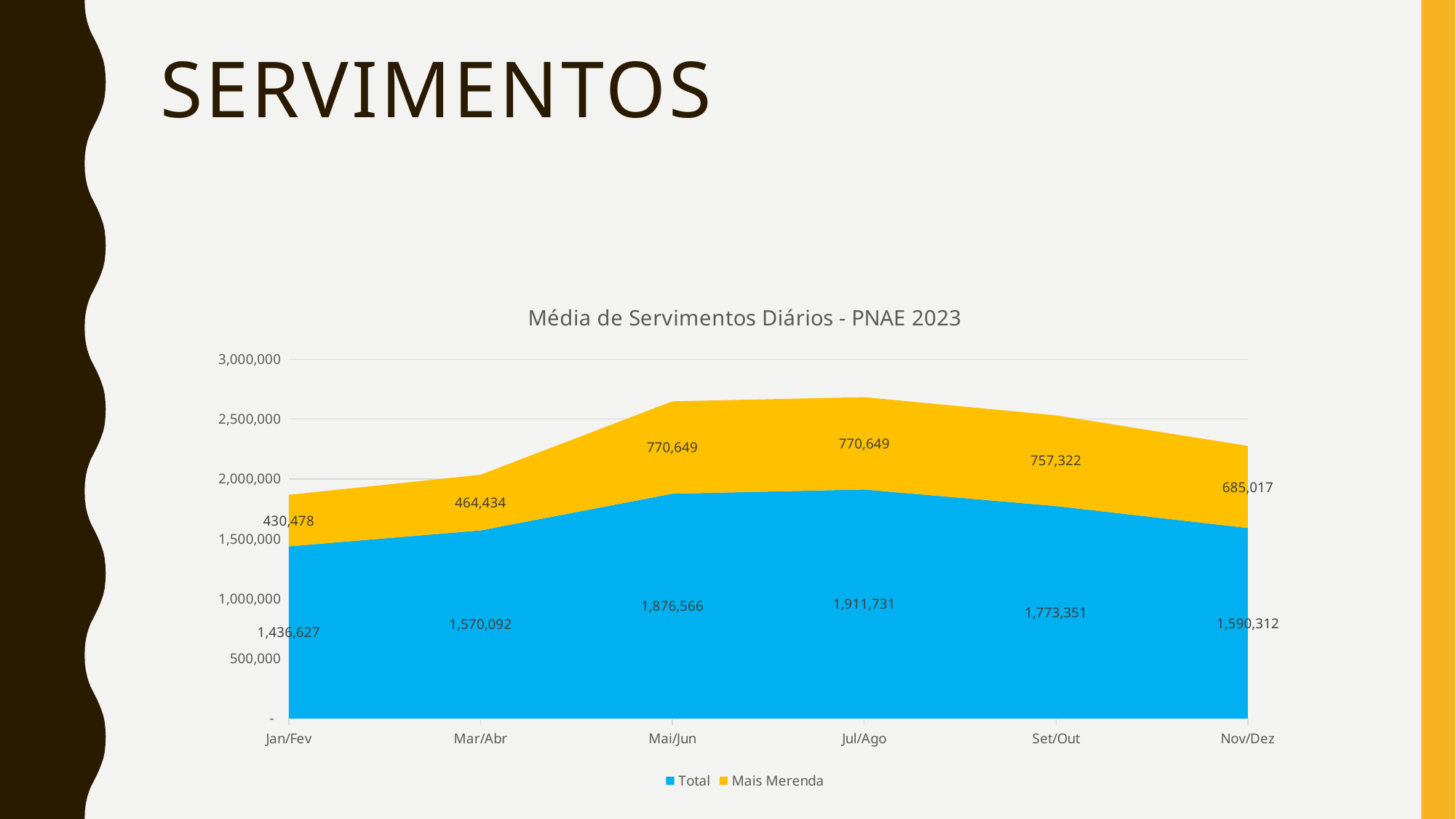
Which is larger, the Total value for Mar/Abr or the Total value for Nov/Dez? Nov/Dez In which period is the Total value highest? Jul/Ago What is the difference between the Total value for Jul/Ago and the Total value for Jan/Fev? 475,104 How many periods are shown on the x axis? 6 In which period is the Mais Merenda value lowest? Jan/Fev What is the combined value of Total and Mais Merenda for Jan/Fev? 1,867,105 What type of chart is shown on the slide? Stacked area chart What is the Mais Merenda value for Set/Out? 757,322 What is the Total value for Mai/Jun? 1,876,566 How many series does the legend list? 2 What is the title of the chart? Média de Servimentos Diários - PNAE 2023 How does the Total value change from Jan/Fev to Jul/Ago? It rises